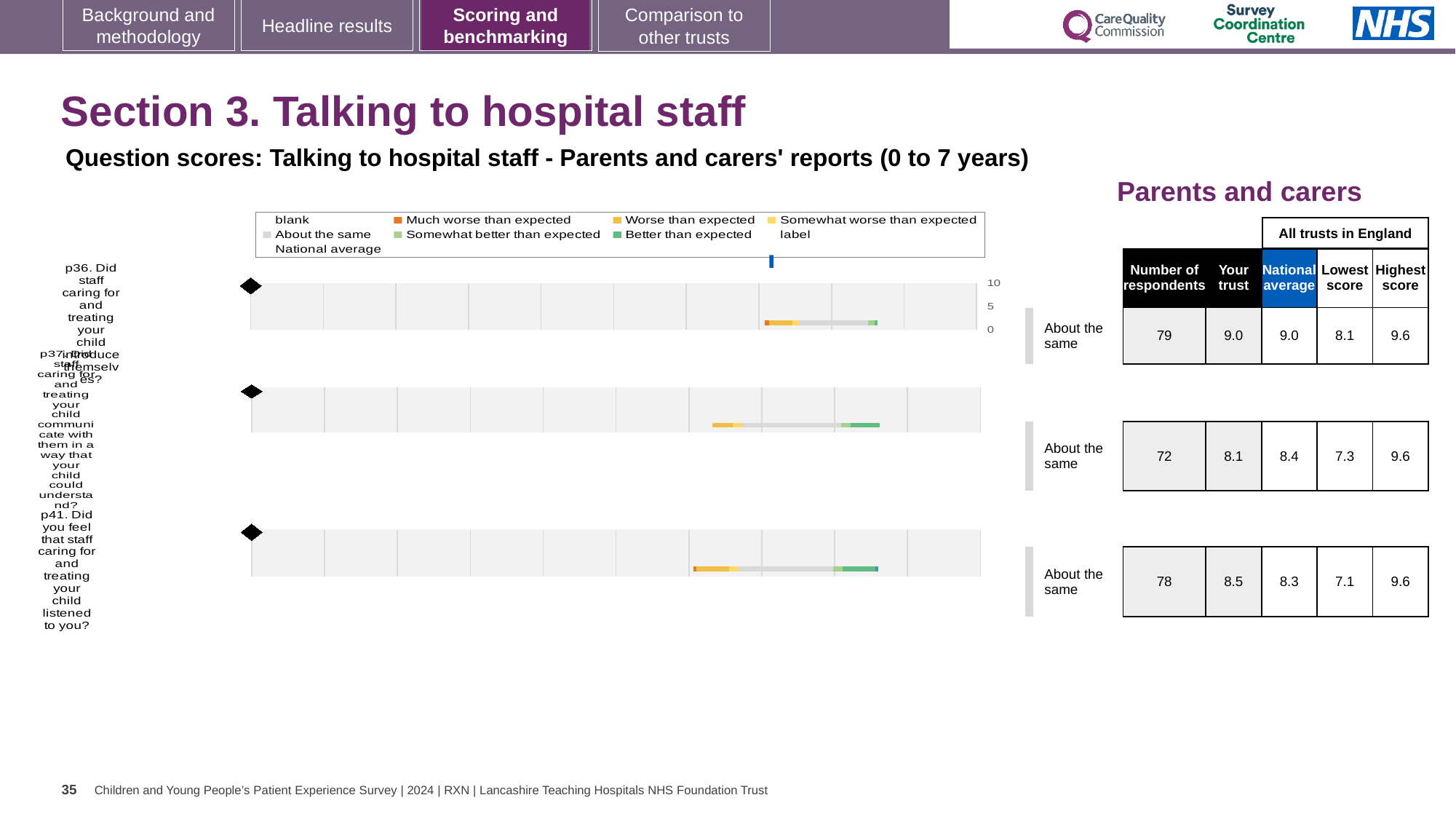
In the chart legend, what colour represents 'Much worse than expected'? orange Which question has the highest 'Your trust' score? p36 For p41, which is larger: the 'Your trust' score or the national average? Your trust How many questions (p36, p37, p41) have a benchmark bar chart on this slide? 3 What kind of chart is used to show the question scores on this slide? bar chart What benchmark category is shown next to each of the three question charts? About the same What is the national average score for p37 (Did staff communicate with your child in a way they could understand?)? 8.4 What is the highest score across all trusts in England for p36? 9.6 How many respondents answered p41 (Did you feel that staff caring for and treating your child listened to you?)? 78 In the chart legend, what does the blue marker represent? National average What is the 'Your trust' score for p36 (Did staff caring for and treating your child introduce themselves?)? 9.0 For p37, what is the difference between the highest score and the lowest score across all trusts in England? 2.3